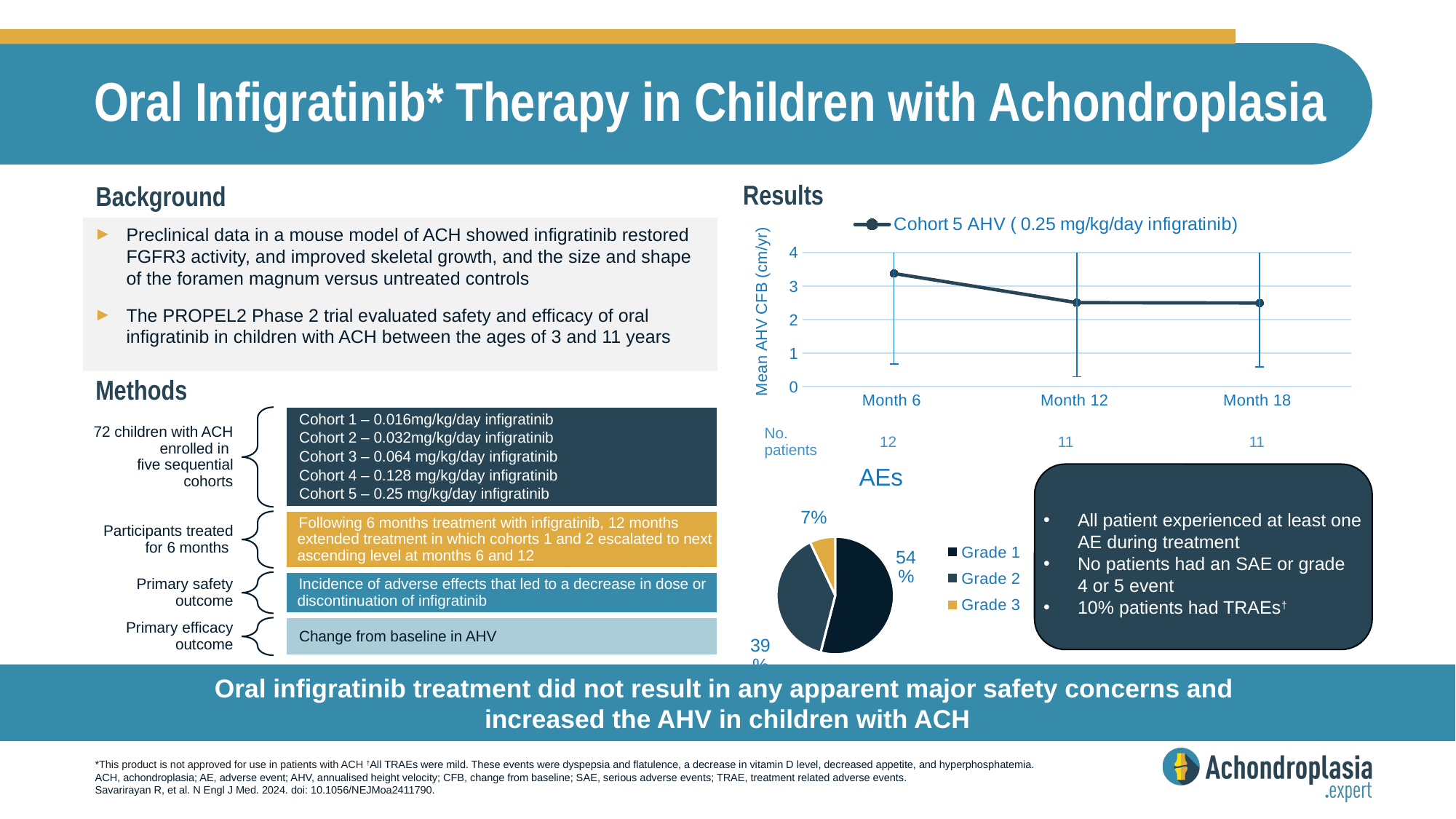
In the 'AEs' pie chart, what share of AEs were Grade 1? 54% In the 'Cohort 5 AHV' line chart, how many patients are listed at Month 6? 12 What kind of chart is the 'AEs' chart on the slide? Pie chart In the 'AEs' pie chart, which grade has the smallest share? Grade 3 In the 'Cohort 5 AHV' line chart, is the value at Month 12 greater or less than 3? less What kind of chart is the 'Cohort 5 AHV' chart on the slide? Line chart In the 'Cohort 5 AHV' line chart, is the value at Month 18 greater or less than 2? greater In the 'Cohort 5 AHV' line chart, is the value at Month 6 greater or less than 3? greater In the 'Cohort 5 AHV' line chart, how many time points are plotted on the x axis? 3 In the 'Cohort 5 AHV' line chart, which time point has the highest mean AHV CFB? Month 6 In the 'AEs' pie chart, what is the difference in percentage points between the Grade 1 and Grade 2 shares? 15 In the 'Cohort 5 AHV' line chart, does the mean AHV CFB rise or fall from Month 6 to Month 12? Fall